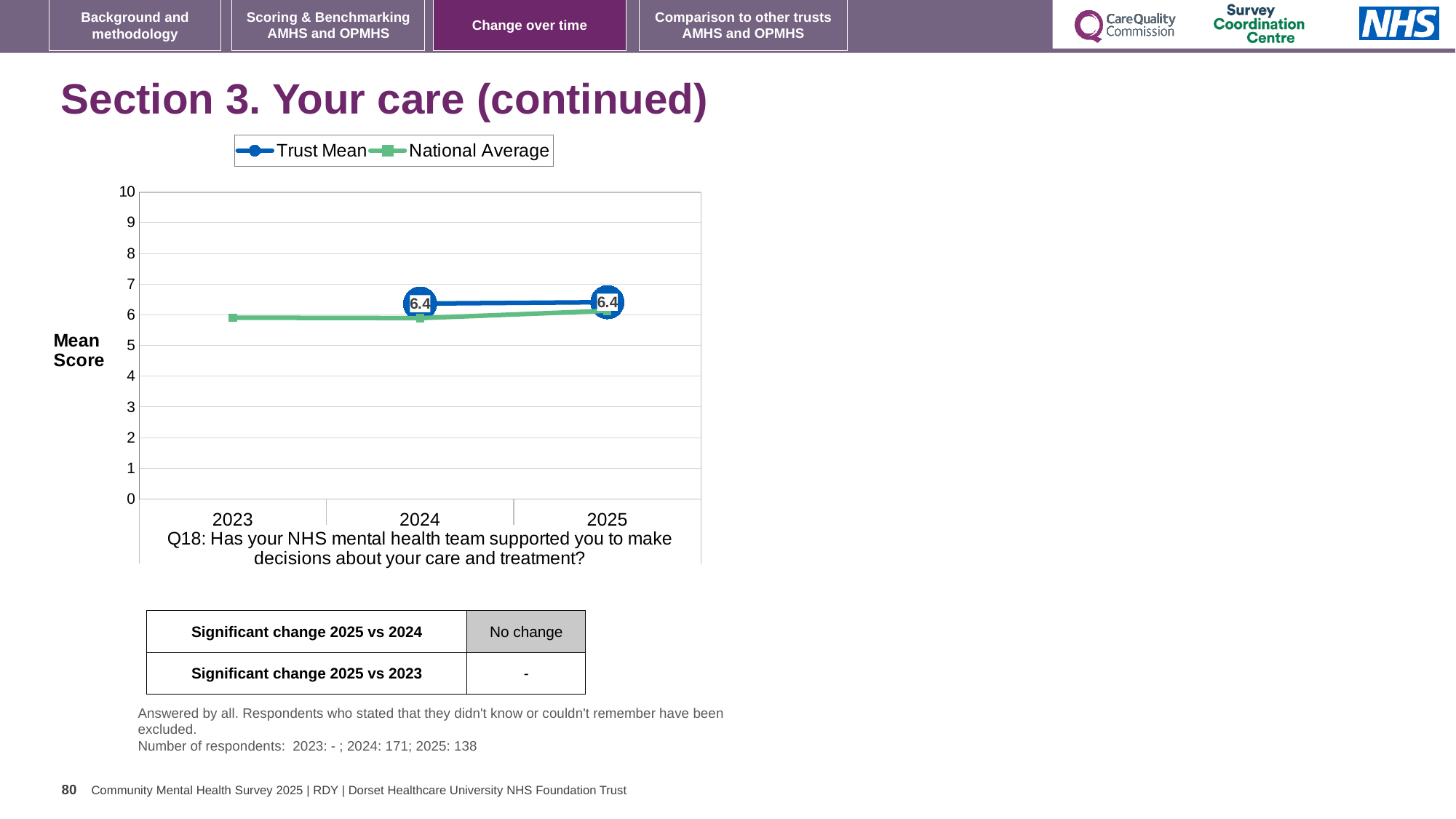
What is the Trust Mean value for 2025? 6.4 How many series does the legend list? 2 Which survey question does the chart relate to? Q18: Has your NHS mental health team supported you to make decisions about your care and treatment? What is the Trust Mean value for 2024? 6.4 Is the National Average value for 2025 greater or less than 5? greater What kind of chart is shown on the slide? Line chart In 2024, which is larger: the Trust Mean or the National Average? Trust Mean What is the difference between the Trust Mean in 2025 and the Trust Mean in 2024? 0 Is the National Average value for 2023 greater or less than 7? less What is the label on the y axis of the chart? Mean Score Does the National Average rise or fall from 2024 to 2025? rise How many years are shown on the x axis? 3